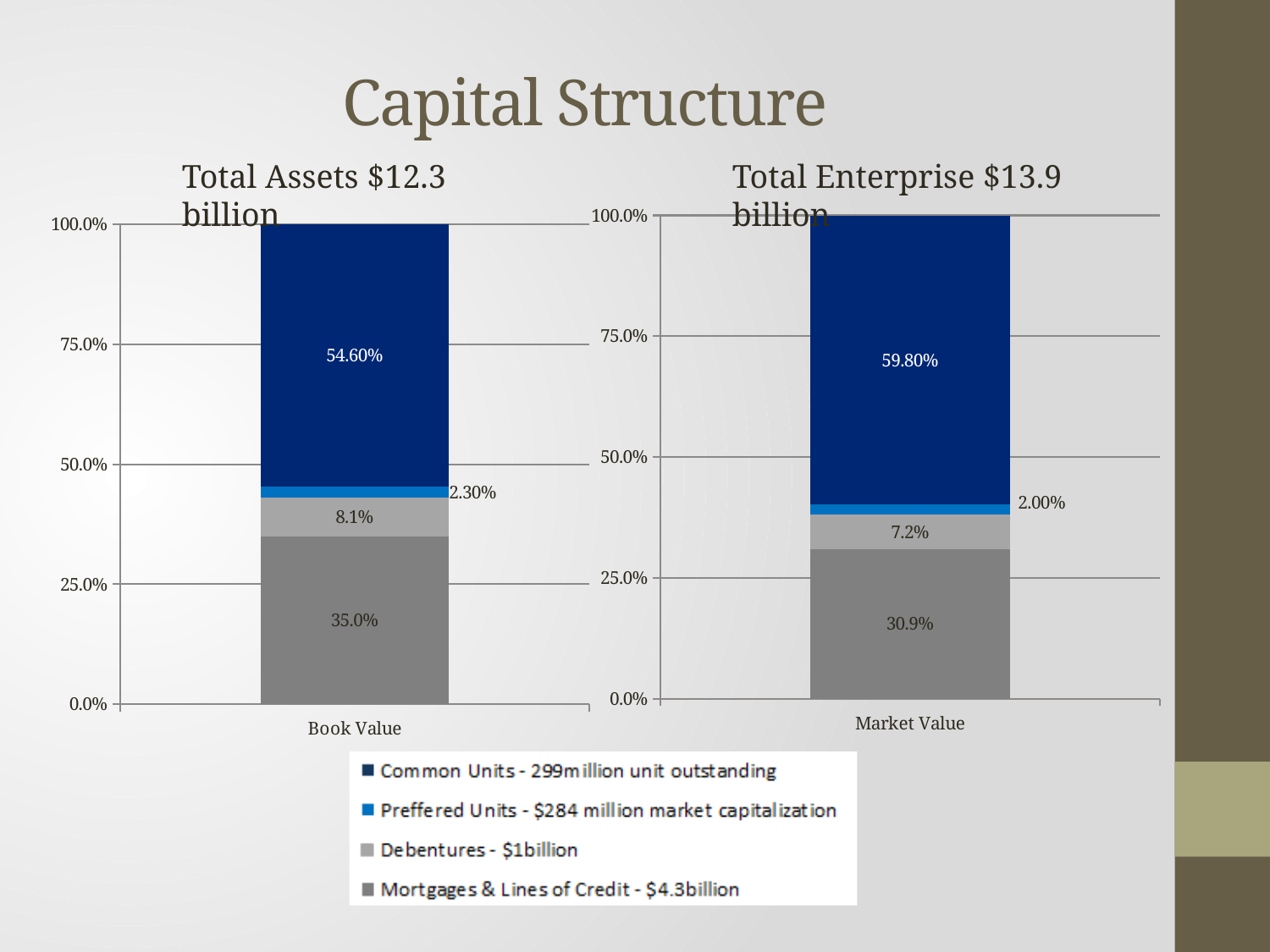
In the Total Enterprise $13.9 billion chart, which series has the smallest share of the Market Value bar? Preferred Units In the Total Assets $12.3 billion chart, which series has the largest share of the Book Value bar? Common Units What is the difference between the Common Units share in the Market Value bar (59.80%) and in the Book Value bar (54.60%)? 5.20% According to the legend, what is the market capitalization of the Preferred Units? $284 million Is the Mortgages & Lines of Credit share larger in the Book Value bar or the Market Value bar? Book Value In the Total Assets $12.3 billion chart, what percentage is shown for Debentures? 8.1% In the Total Enterprise $13.9 billion chart, what percentage is shown for Mortgages & Lines of Credit in the Market Value bar? 30.9% In the Total Enterprise $13.9 billion chart, what percentage is shown for Preferred Units? 2.00% What kind of chart is the Total Assets $12.3 billion chart? Stacked bar chart What is the total of the Market Value stacked bar in the Total Enterprise $13.9 billion chart (59.80% + 2.00% + 7.2% + 30.9%)? 99.9% In the Total Assets $12.3 billion chart, what percentage is shown for Common Units in the Book Value bar? 54.60% How many series does the legend list? 4